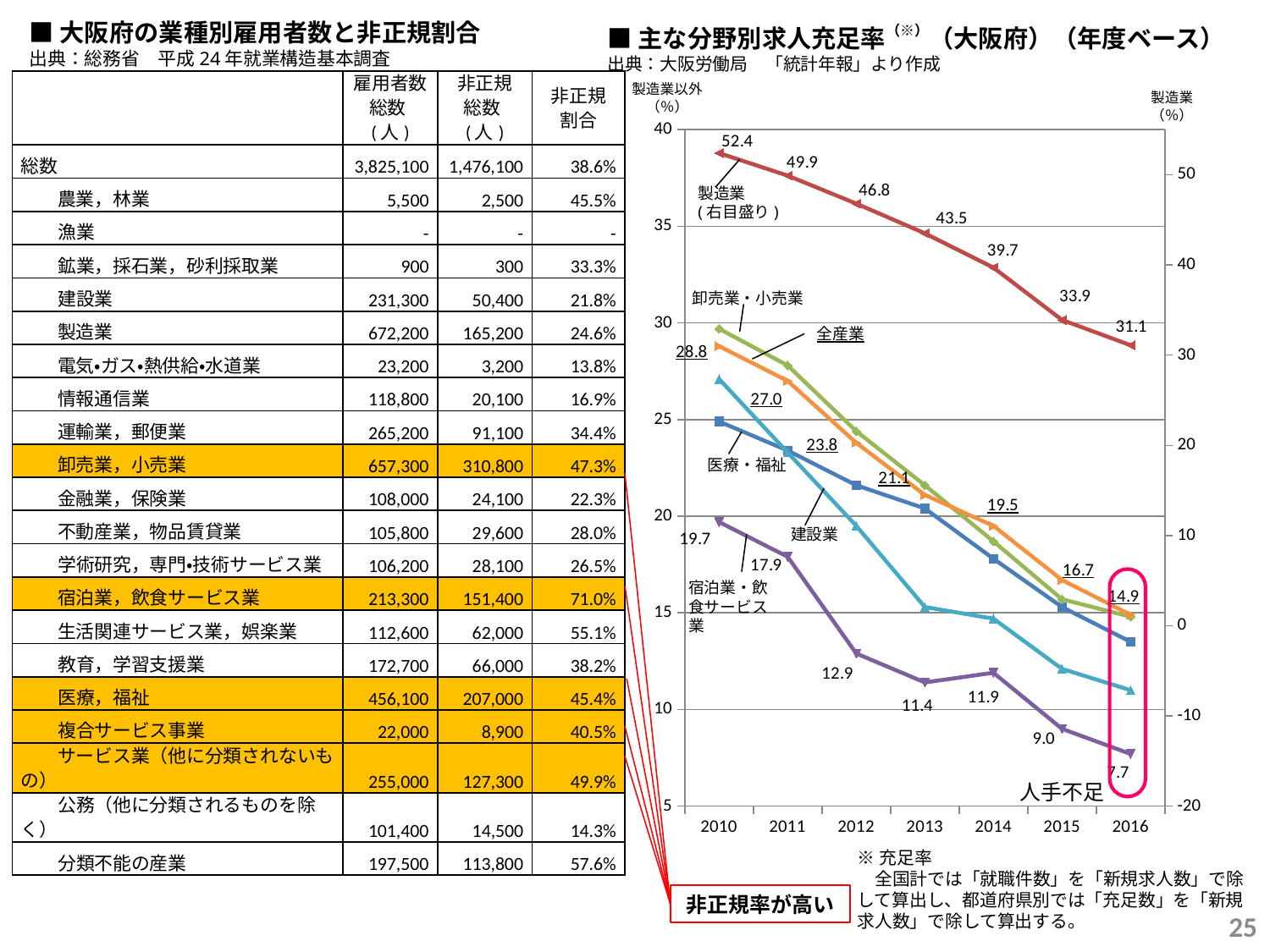
In the 主な分野別求人充足率 chart, which is larger in 2016: the 全産業 value or the 宿泊業・飲食サービス業 value? 全産業 In the 主な分野別求人充足率 chart, what is the value for 全産業 in 2013? 21.1 In the 主な分野別求人充足率 chart, does the 製造業 line rise or fall from 2010 to 2016? fall What type of chart is shown on the right side of the slide (主な分野別求人充足率)? line chart In the 主な分野別求人充足率 chart, by how much did the 製造業 value decrease from 2010 to 2016? 21.3 In the 主な分野別求人充足率 chart, what is the value for 宿泊業・飲食サービス業 in 2016? 7.7 In the 主な分野別求人充足率 chart, what is the value for 製造業 in 2010? 52.4 In the 主な分野別求人充足率 chart, what is the value for 製造業 in 2016? 31.1 In the 主な分野別求人充足率 chart, what is the difference between the 全産業 value in 2010 (28.8) and in 2016 (14.9)? 13.9 In the 主な分野別求人充足率 chart, what is the value for 宿泊業・飲食サービス業 in 2012? 12.9 In the 主な分野別求人充足率 chart, how many years are plotted on the x axis? 7 In the 主な分野別求人充足率 chart, is the 建設業 value in 2016 greater or less than 15? less